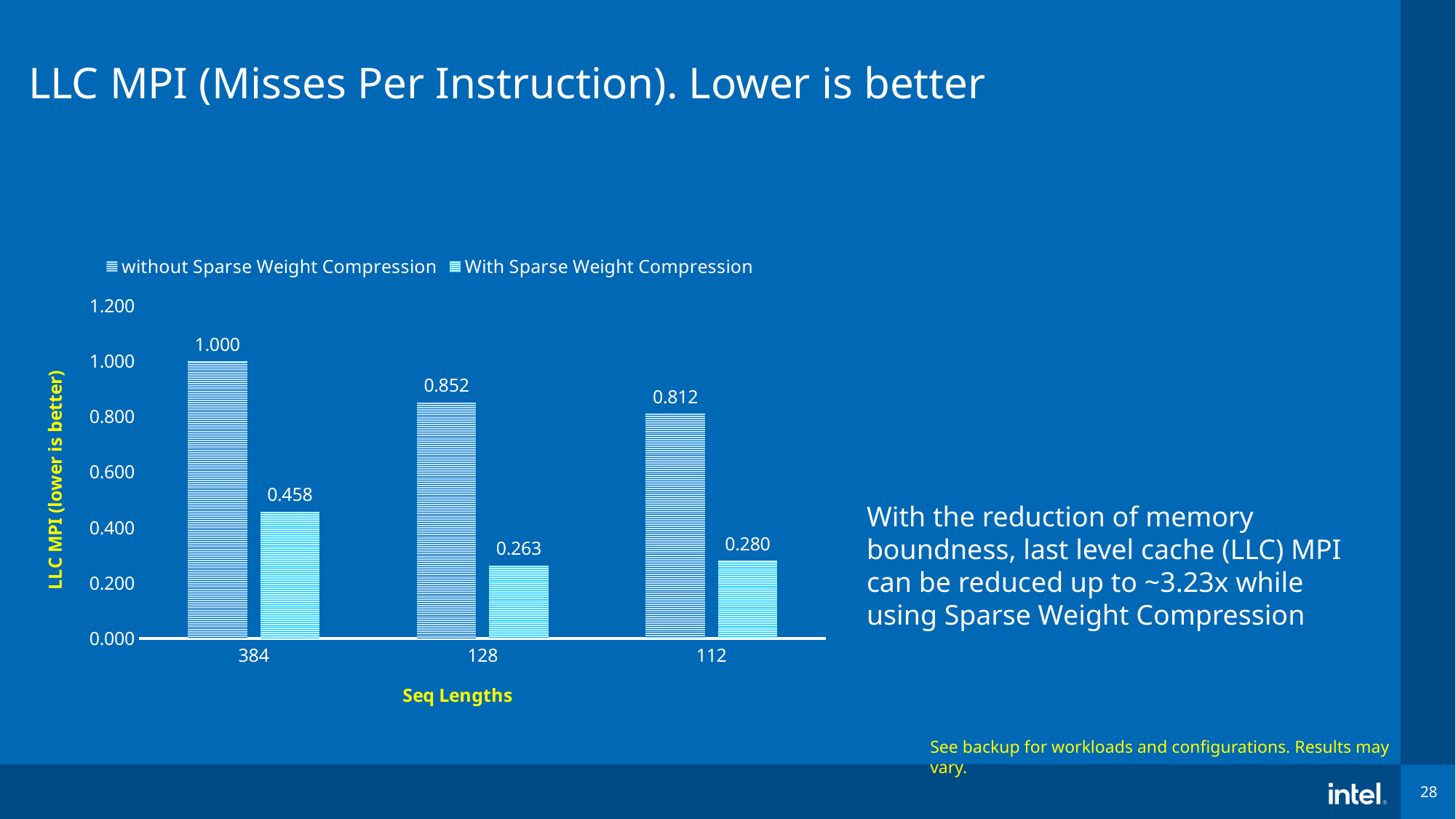
At sequence length 112, which series has the larger LLC MPI value: without Sparse Weight Compression or With Sparse Weight Compression? without Sparse Weight Compression Is the LLC MPI value with Sparse Weight Compression at sequence length 384 greater or less than 0.400? greater What is the LLC MPI value without Sparse Weight Compression at sequence length 384? 1.000 Which sequence length has the highest LLC MPI value with Sparse Weight Compression? 384 What is the LLC MPI value without Sparse Weight Compression at sequence length 112? 0.812 How many sequence lengths are shown on the x axis? 3 How many series does the legend list? 2 What kind of chart is shown on the slide? bar chart What is the label of the x axis? Seq Lengths What is the difference between the LLC MPI values without and with Sparse Weight Compression at sequence length 384? 0.542 What is the LLC MPI value with Sparse Weight Compression at sequence length 128? 0.263 Which sequence length has the lowest LLC MPI value without Sparse Weight Compression? 112